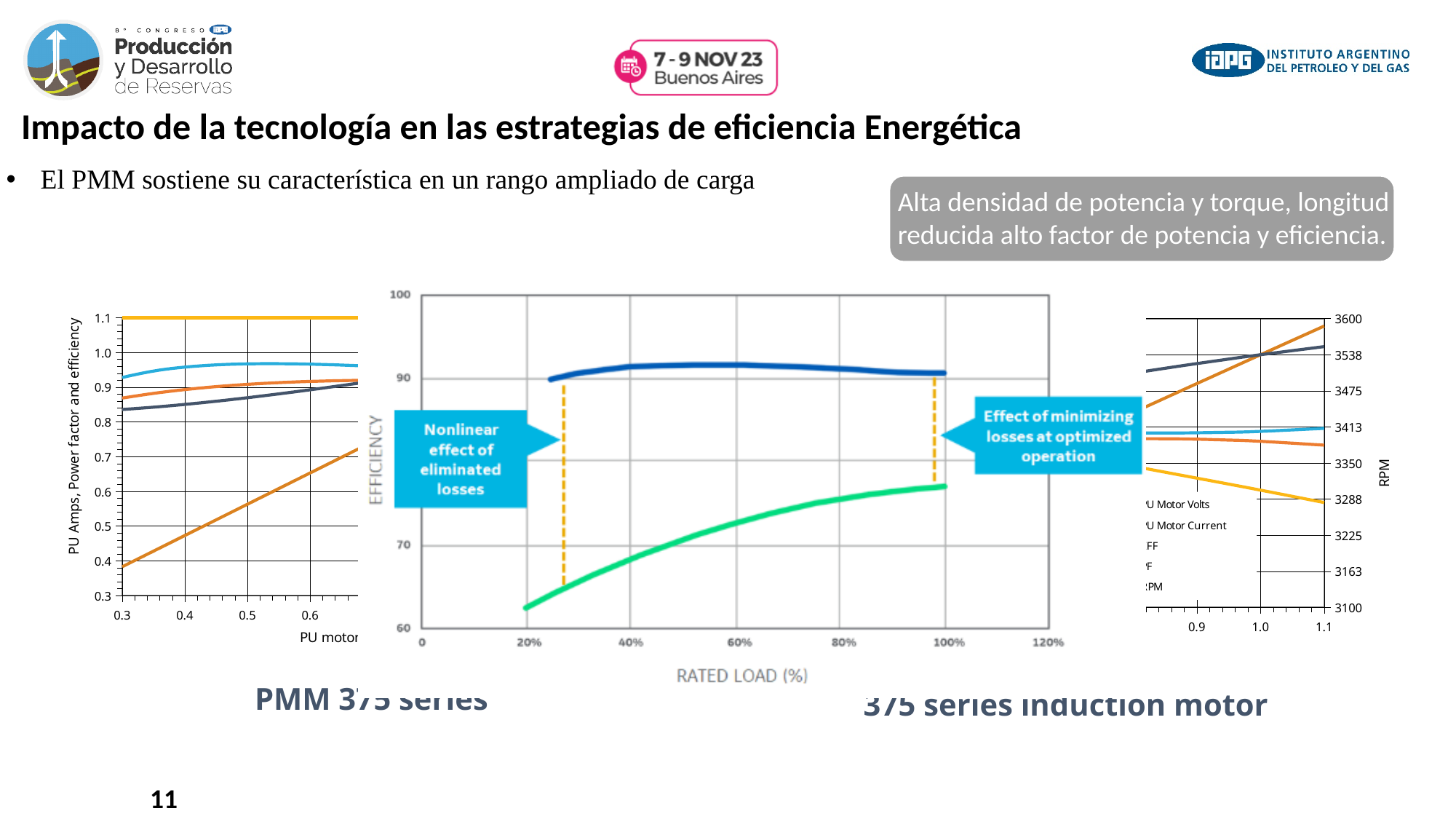
In the left chart (PMM 375 series), is the value of the rising orange-brown line at x = 0.3 greater or less than 0.5? less In the middle chart (Efficiency vs Rated Load), at 100% rated load, which line is higher, the dark blue line or the green line? the dark blue line In the middle chart (Efficiency vs Rated Load), is the dark blue line's efficiency at 60% rated load greater or less than 90? greater In the middle chart (Efficiency vs Rated Load), is the green line's efficiency at 20% rated load greater or less than 70? less What is the x-axis title of the middle chart? RATED LOAD (%) What kind of chart is the middle chart with the x axis 'RATED LOAD (%)'? line chart In the left chart (PMM 375 series), what is the y-axis title? PU Amps, Power factor and efficiency In the middle chart (Efficiency vs Rated Load), does the green line rise or fall as rated load increases from 20% to 100%? rises In the left chart (PMM 375 series), does the lowest (orange-brown) line rise or fall as the x value increases from 0.3 to 0.6? rises In the middle chart (Efficiency vs Rated Load), how many lines are plotted? 2 In the right chart (375 series induction motor), does the yellow line rise or fall as the x value increases from 0.9 to 1.1? falls